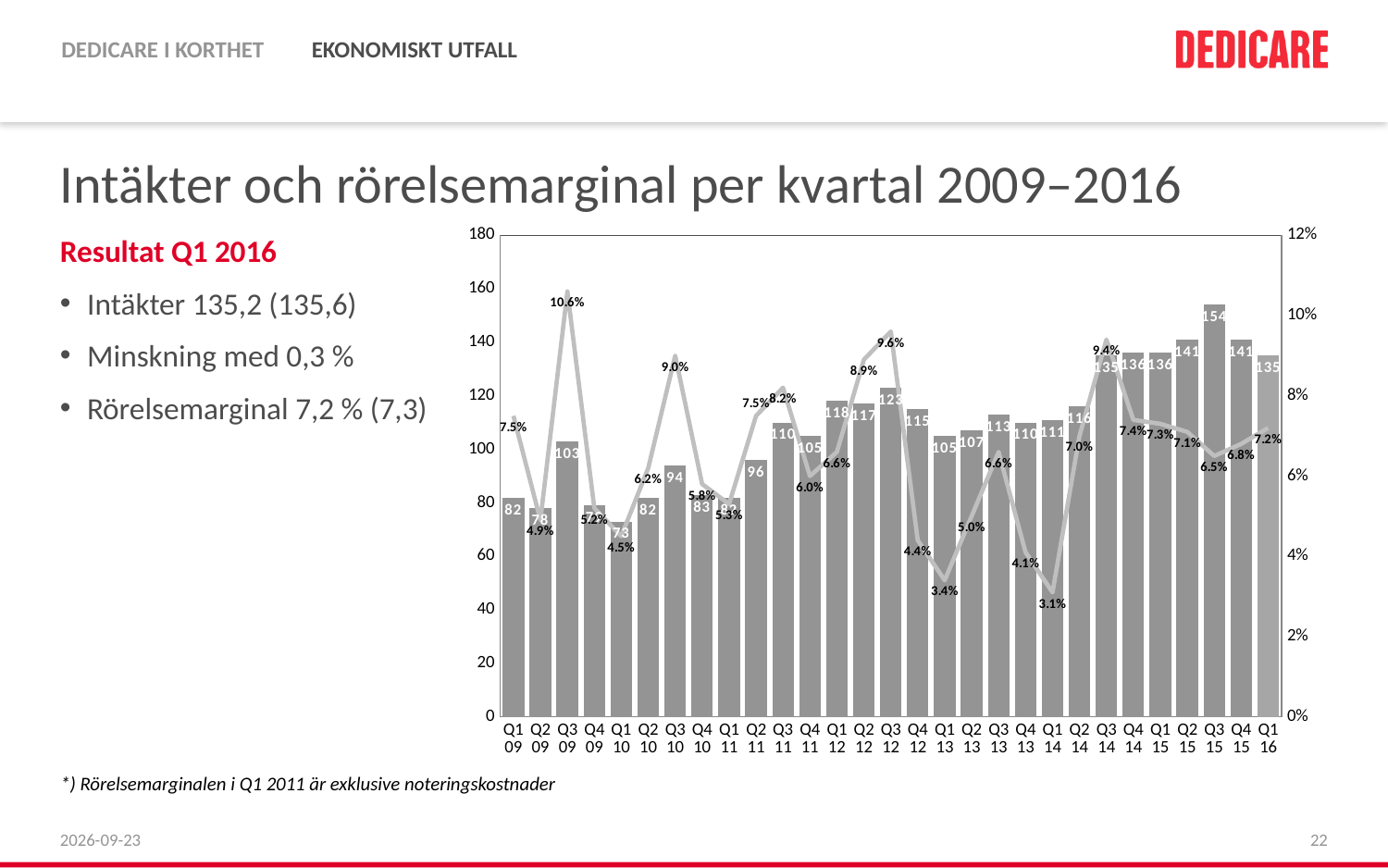
Which quarter has the highest revenue bar? Q3 15 Which quarter has the lowest operating margin on the line? Q1 14 What kind of chart is shown on the slide? Combined bar and line chart What is the revenue bar value for Q3 12? 123 Which quarter has the highest operating margin on the line? Q3 09 Which quarter has the lowest revenue bar? Q1 10 Is the revenue bar for Q1 10 greater or less than 80? less Which is larger, the revenue bar for Q3 09 or for Q3 10? Q3 09 How many quarters are shown on the x axis? 29 What is the difference between the revenue bars for Q3 12 and Q4 12? 8 What is the operating margin (line value) shown for Q1 16? 7.2% What is the revenue bar value for Q3 15? 154